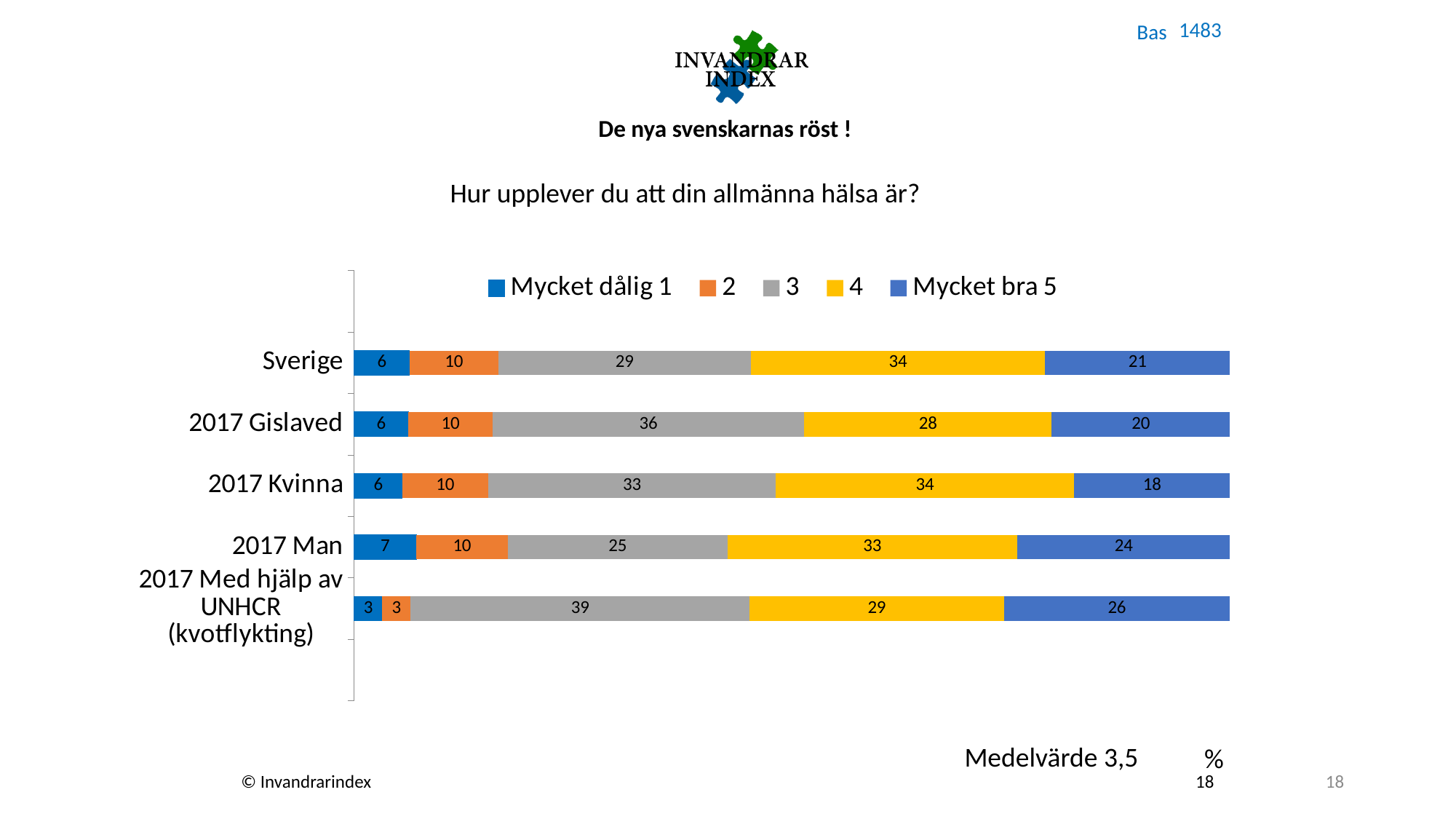
How many series does the legend list? 5 What is the value of the "3" series for 2017 Gislaved? 36 What is the value of "Mycket bra 5" for 2017 Man? 24 What is the value of the "4" series for Sverige? 34 How many categories are shown on the chart? 5 What is the total of the stacked bar for 2017 Kvinna? 101 What is the difference between the "3" series values for 2017 Med hjälp av UNHCR (kvotflykting) and 2017 Man? 14 What kind of chart is shown on the slide? Stacked bar chart Which category has the highest value for "Mycket bra 5"? 2017 Med hjälp av UNHCR (kvotflykting) Which category has the lowest value for the "3" series? 2017 Man Which is larger: the "Mycket bra 5" value for 2017 Kvinna or for 2017 Gislaved? 2017 Gislaved What is the value of "Mycket dålig 1" for 2017 Med hjälp av UNHCR (kvotflykting)? 3